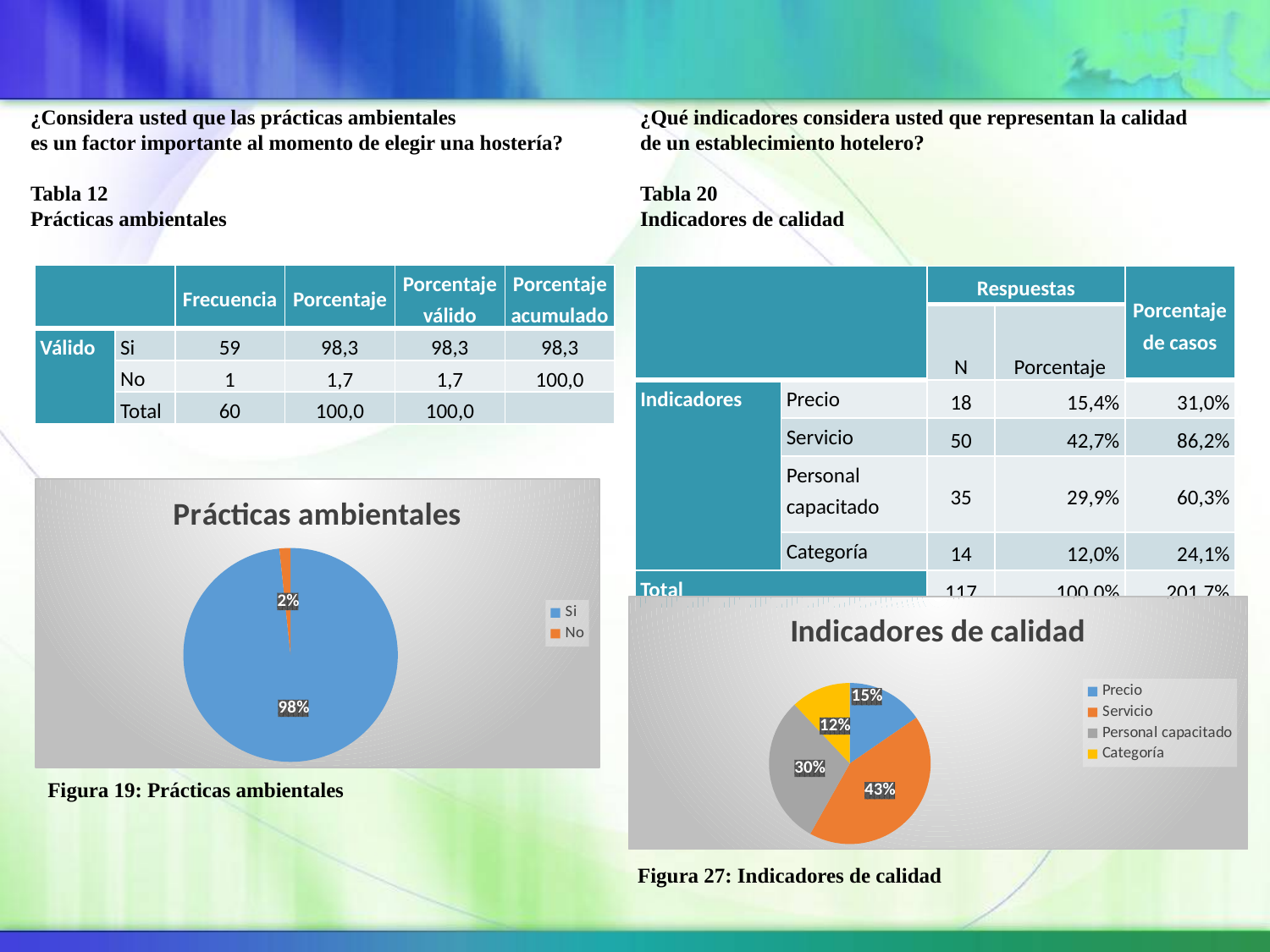
In the 'Indicadores de calidad' chart, which is larger, 'Precio' or 'Personal capacitado'? Personal capacitado In the 'Indicadores de calidad' chart, what share of the pie is 'Categoría'? 12% How many entries does the legend of the 'Prácticas ambientales' chart list? 2 In the 'Indicadores de calidad' chart, what is the difference in percentage points between 'Servicio' and 'Precio'? 28 In the 'Indicadores de calidad' chart, what share of the pie is 'Personal capacitado'? 30% In the 'Indicadores de calidad' chart, which category has the smallest slice? Categoría In the 'Indicadores de calidad' chart, which category has the largest slice? Servicio What kind of chart is 'Prácticas ambientales'? pie chart In the 'Indicadores de calidad' chart, what share of the pie is 'Servicio'? 43% In the 'Prácticas ambientales' chart, what share of the pie is labelled 'No'? 2% How many categories does the 'Indicadores de calidad' pie chart show? 4 In the 'Prácticas ambientales' chart, what share of the pie is labelled 'Si'? 98%